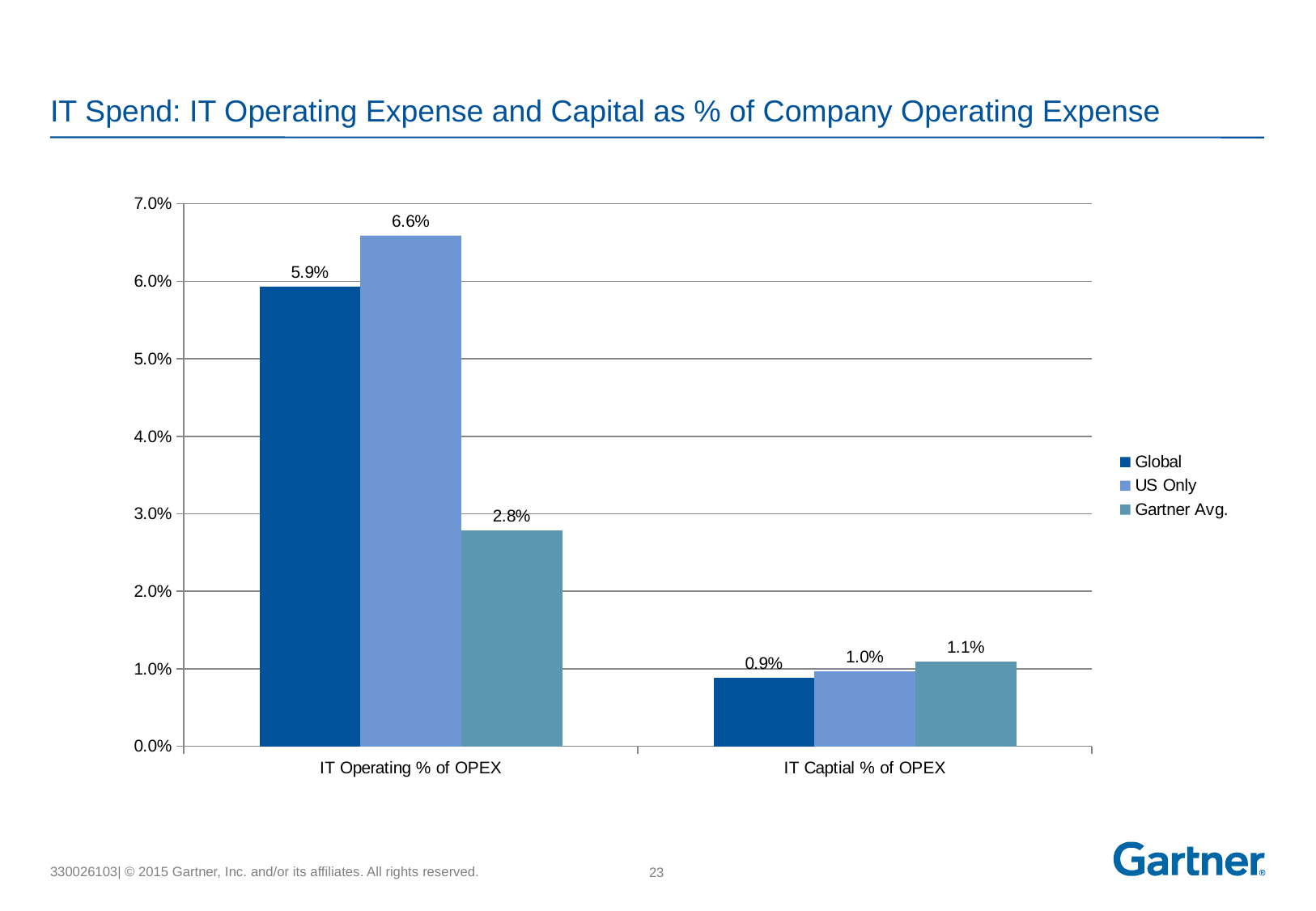
Which series has the lowest value for IT Operating % of OPEX? Gartner Avg. What is the Global value for IT Captial % of OPEX? 0.9% What is the difference between the US Only and Global values for IT Operating % of OPEX? 0.7% What is the Global value for IT Operating % of OPEX? 5.9% What is the difference between the Global and Gartner Avg. values for IT Operating % of OPEX? 3.1% Which series has the highest value for IT Operating % of OPEX? US Only Which is larger: the Global value for IT Operating % of OPEX or the Gartner Avg. value for IT Operating % of OPEX? Global What is the Gartner Avg. value for IT Captial % of OPEX? 1.1% How many series does the legend list? 3 What kind of chart is shown on the slide? Bar chart What is the US Only value for IT Operating % of OPEX? 6.6% How many categories are shown on the x axis? 2